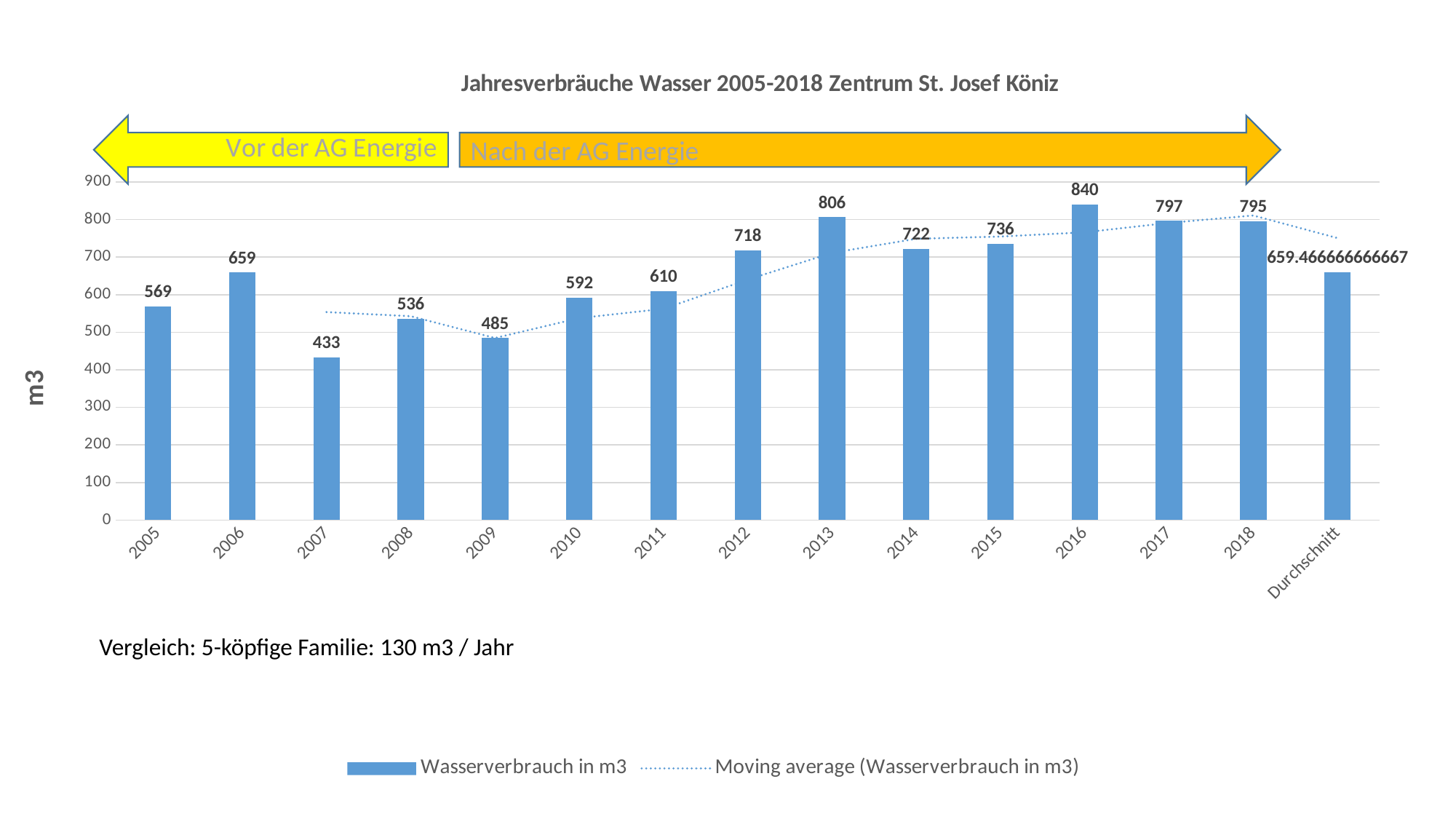
Is the value for 2009 greater or less than 500? less What kind of chart is shown on the slide? bar chart Which year has the highest water consumption? 2016 What is the difference between the values for 2016 and 2005? 271 What is the title of the chart? Jahresverbräuche Wasser 2005-2018 Zentrum St. Josef Köniz What value is labelled on the Durchschnitt bar? 659.466666666667 What is the value shown for 2007? 433 How many bars are plotted in the chart? 15 What is the water consumption value for 2013? 806 Which is larger, the value for 2012 or the value for 2014? 2014 Which year has the lowest water consumption? 2007 How many series does the legend list? 2